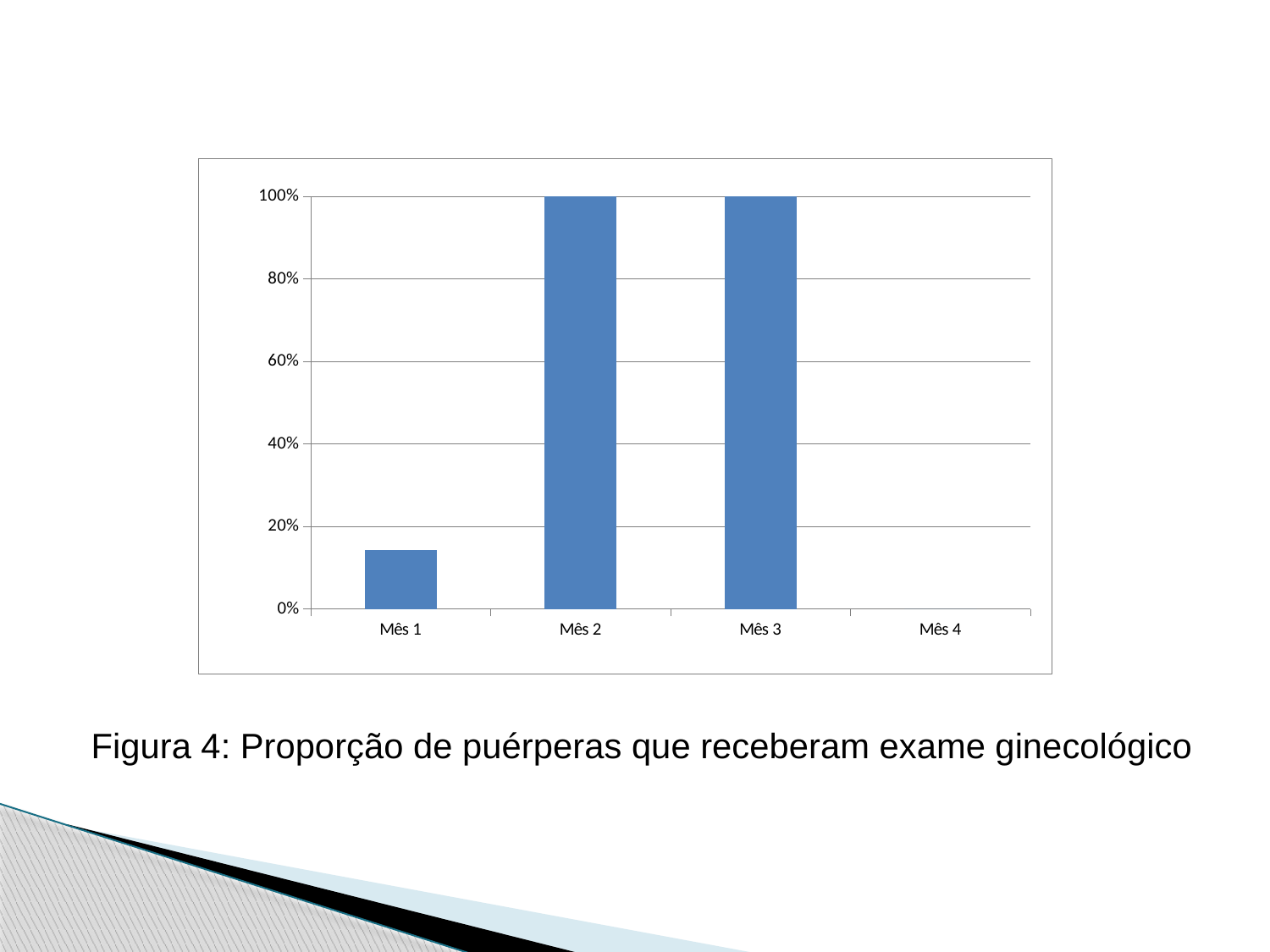
Is the value for Mês 1 greater or less than 20%? less Which category has the lowest value? Mês 4 Which is larger, the value for Mês 1 or the value for Mês 2? Mês 2 What is the difference between the value for Mês 2 and the value for Mês 4? 100% How many categories are shown on the x axis of the chart? 4 Which is larger, the value for Mês 3 or the value for Mês 4? Mês 3 What is the highest value shown on the y axis of the chart? 100% What kind of chart is shown on the slide? bar chart What is the value for Mês 2? 100% What is the caption given for the chart on the slide? Figura 4: Proporção de puérperas que receberam exame ginecológico What is the value for Mês 3? 100% What is the value for Mês 4? 0%